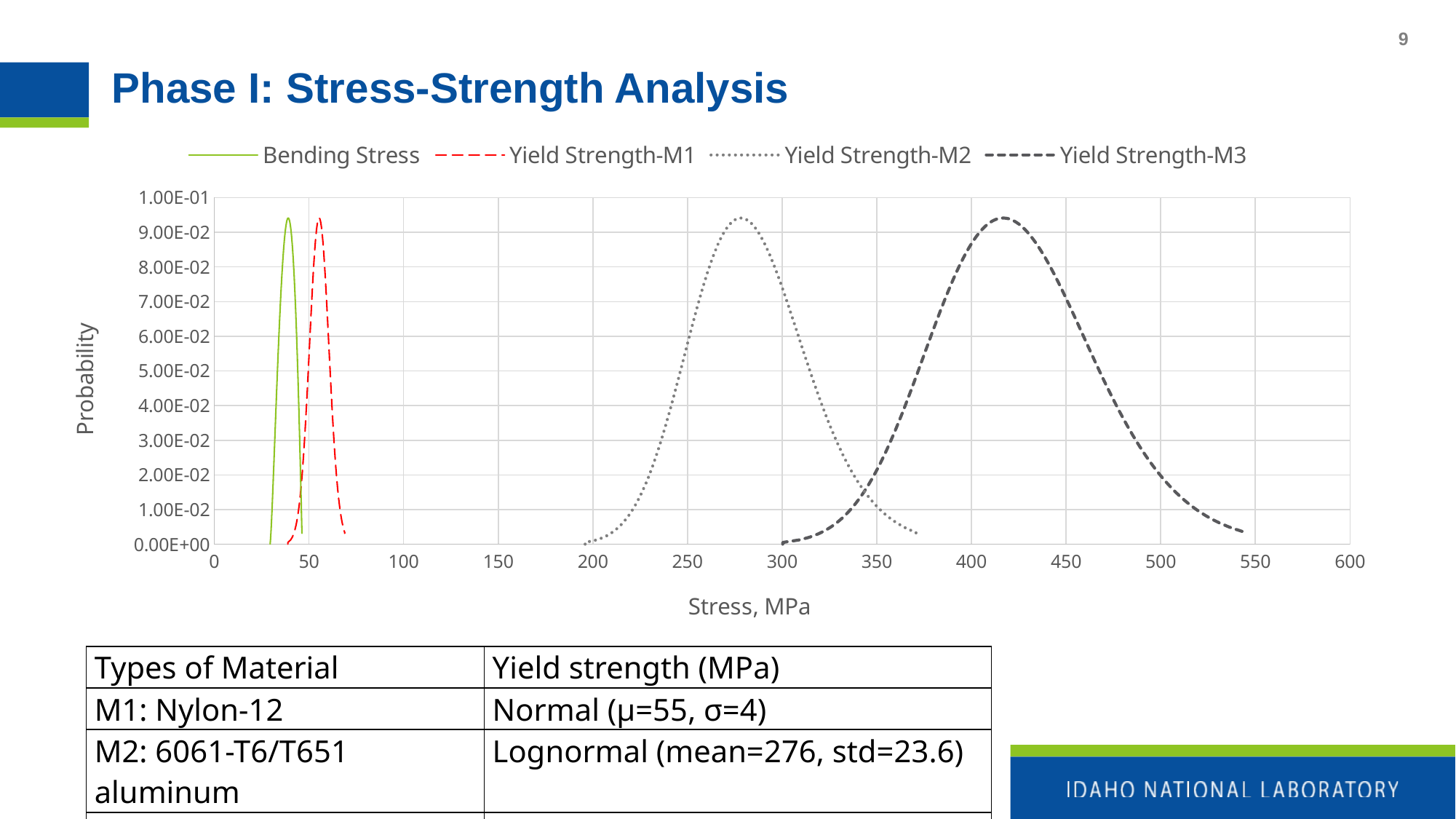
Is the stress at which Bending Stress peaks greater or less than 50? less Which series has its peak at the lowest stress value on the x axis? Bending Stress Is the peak probability of Yield Strength-M3 greater or less than 9.00E-02? greater Which series peaks at a higher stress value, Yield Strength-M1 or Yield Strength-M2? Yield Strength-M2 Is the peak probability of Bending Stress greater or less than 1.00E-01? less What kind of chart is shown on the slide? Line chart How many series does the chart legend list? 4 Which series has its peak at the highest stress value on the x axis? Yield Strength-M3 What is the title of the y axis of the chart? Probability What is the title of the x axis of the chart? Stress, MPa